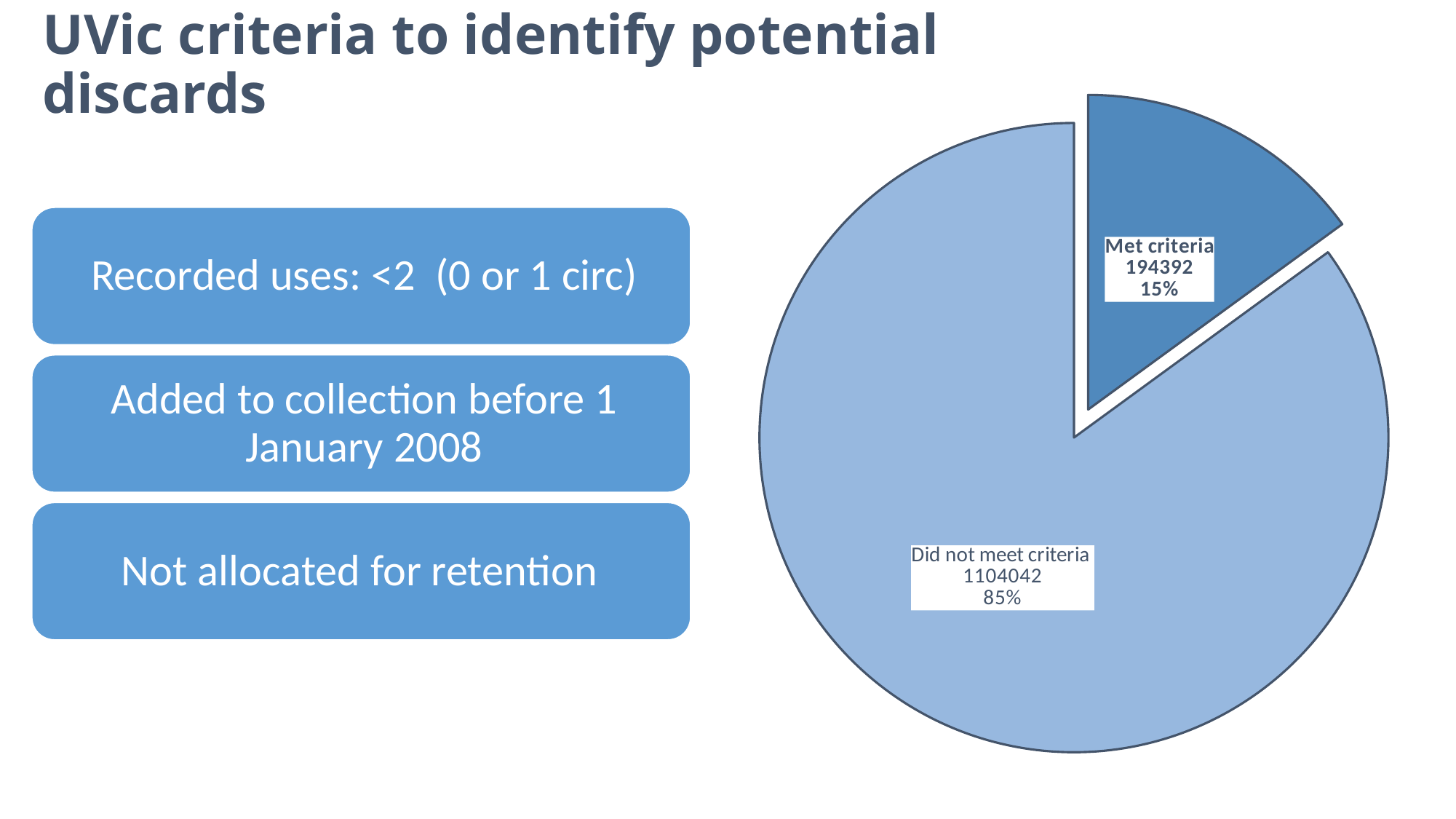
Which slice is pulled out (exploded) from the pie chart? Met criteria What is the difference between the 'Did not meet criteria' and 'Met criteria' values? 909650 What is the value for the 'Did not meet criteria' slice? 1104042 Which is larger, 'Met criteria' or 'Did not meet criteria'? Did not meet criteria What is the total of the two slices in the pie chart? 1298434 Which slice is the smallest in the pie chart? Met criteria What share of the pie does the 'Did not meet criteria' slice represent? 85% What is the value for the 'Met criteria' slice? 194392 How many slices does the pie chart have? 2 What kind of chart is shown on the slide? pie chart What share of the pie does the 'Met criteria' slice represent? 15% Which slice is the largest in the pie chart? Did not meet criteria